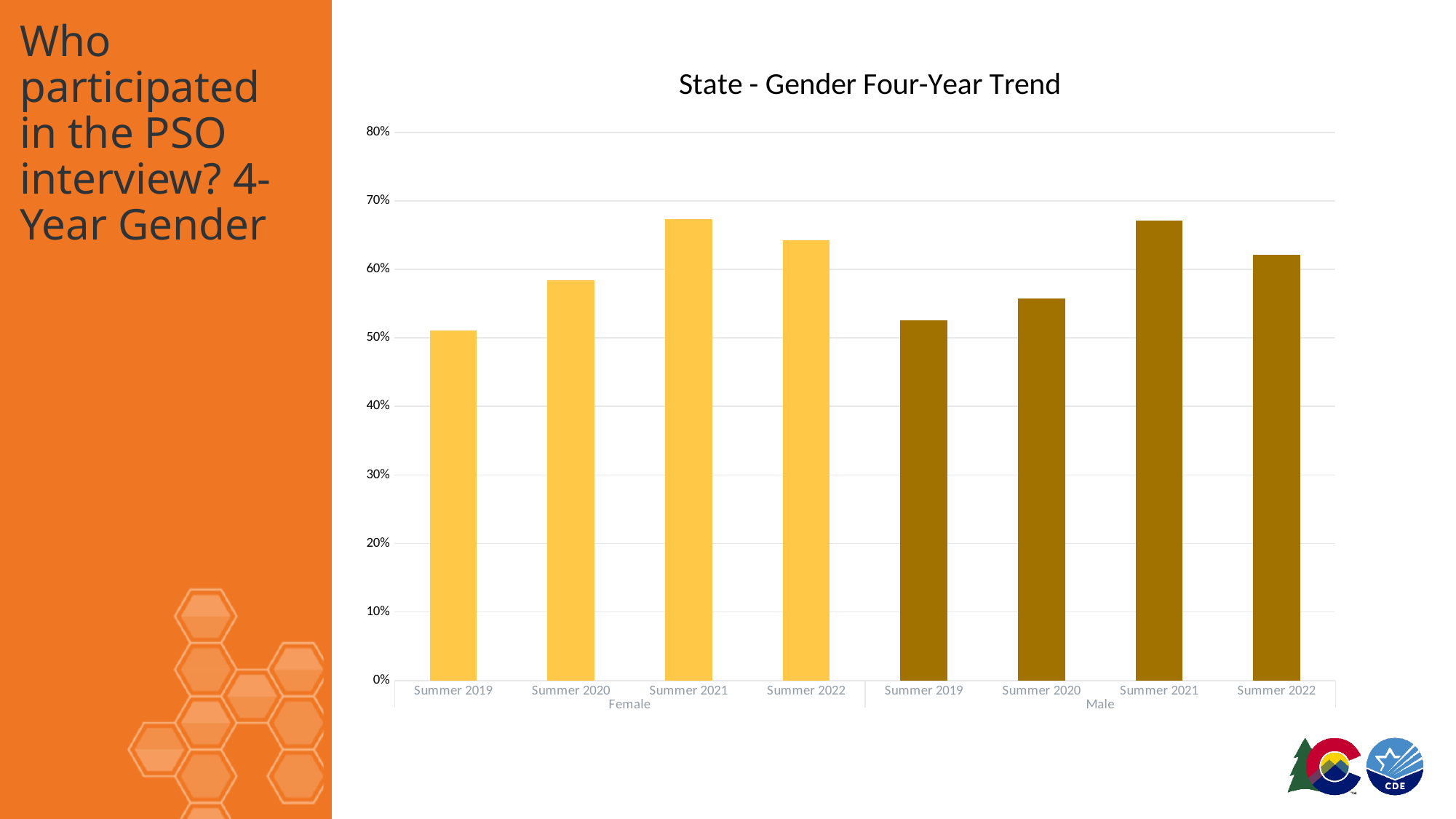
Do the Female values rise or fall from Summer 2019 to Summer 2021? rise Which Summer has the highest value in the Female group? Summer 2021 What kind of chart is shown on the slide? Bar chart Does the Male value rise or fall from Summer 2021 to Summer 2022? fall Which Summer has the lowest value in the Female group? Summer 2019 Is the value for Female Summer 2021 greater or less than 60%? greater How many bars are plotted in the chart? 8 Which Summer has the lowest value in the Male group? Summer 2019 What is the title of the chart? State - Gender Four-Year Trend Is the value for Male Summer 2019 greater or less than 60%? less Which Summer has the highest value in the Male group? Summer 2021 Is the value for Female Summer 2019 greater or less than 60%? less